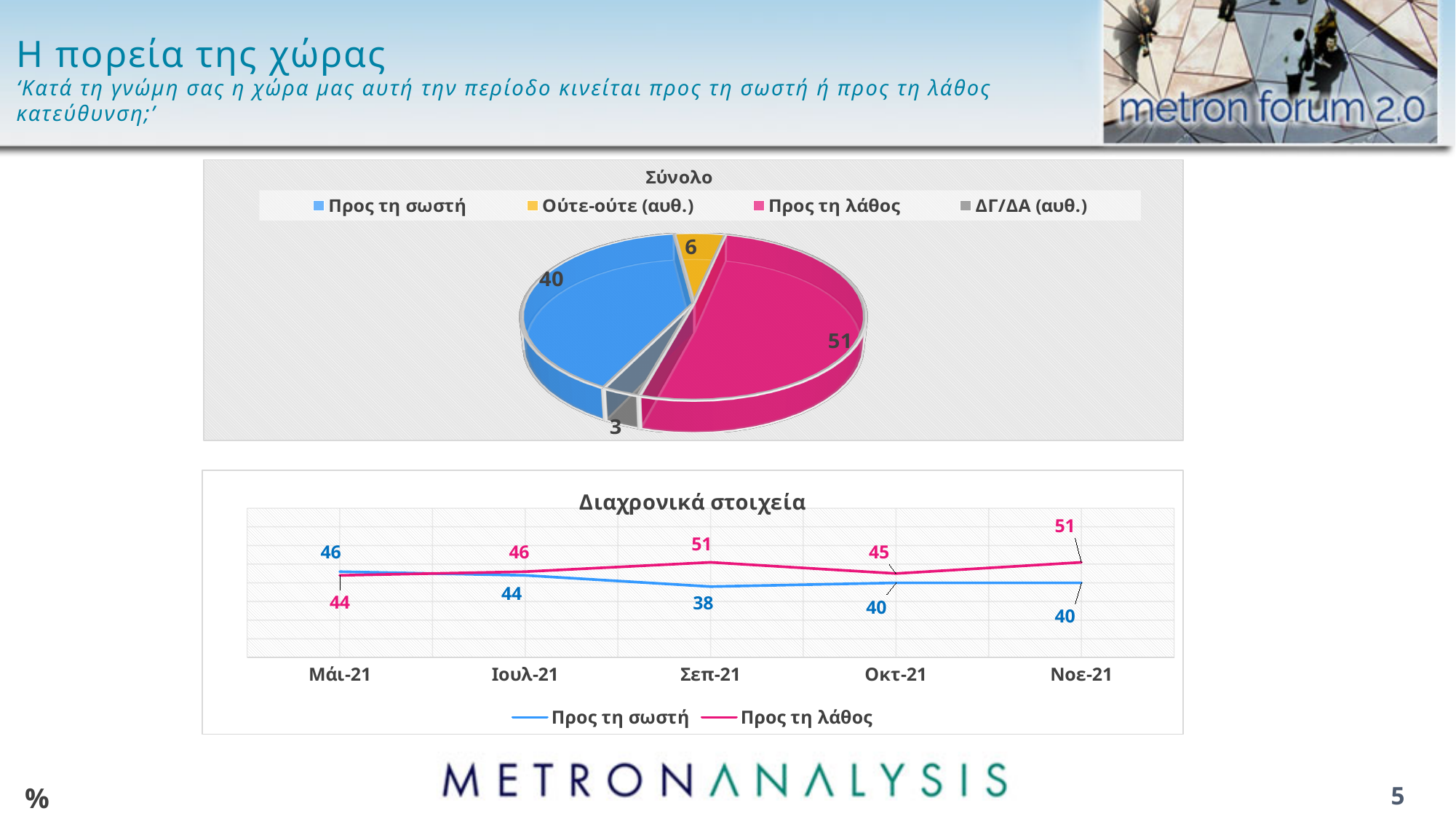
In the 'Διαχρονικά στοιχεία' chart, what is the value for 'Προς τη σωστή' in Σεπ-21? 38 In the 'Διαχρονικά στοιχεία' chart, in which period is 'Προς τη σωστή' at its lowest? Σεπ-21 How many entries does the legend of the 'Σύνολο' chart list? 4 In the 'Σύνολο' chart, which category has the smallest slice? ΔΓ/ΔΑ (αυθ.) In the 'Σύνολο' chart, what is the value for 'Προς τη λάθος'? 51 In the 'Διαχρονικά στοιχεία' chart, which series is higher in Μάι-21, 'Προς τη σωστή' or 'Προς τη λάθος'? Προς τη σωστή In the 'Διαχρονικά στοιχεία' chart, what is the value for 'Προς τη λάθος' in Μάι-21? 44 In the 'Διαχρονικά στοιχεία' chart, what is the difference between 'Προς τη λάθος' and 'Προς τη σωστή' in Νοε-21? 11 In the 'Σύνολο' chart, what is the value for 'Ούτε-ούτε (αυθ.)'? 6 In the 'Σύνολο' chart, what is the difference between 'Προς τη λάθος' and 'Προς τη σωστή'? 11 What kind of chart is the 'Σύνολο' chart? Pie chart How many time periods are shown on the x axis of the 'Διαχρονικά στοιχεία' chart? 5